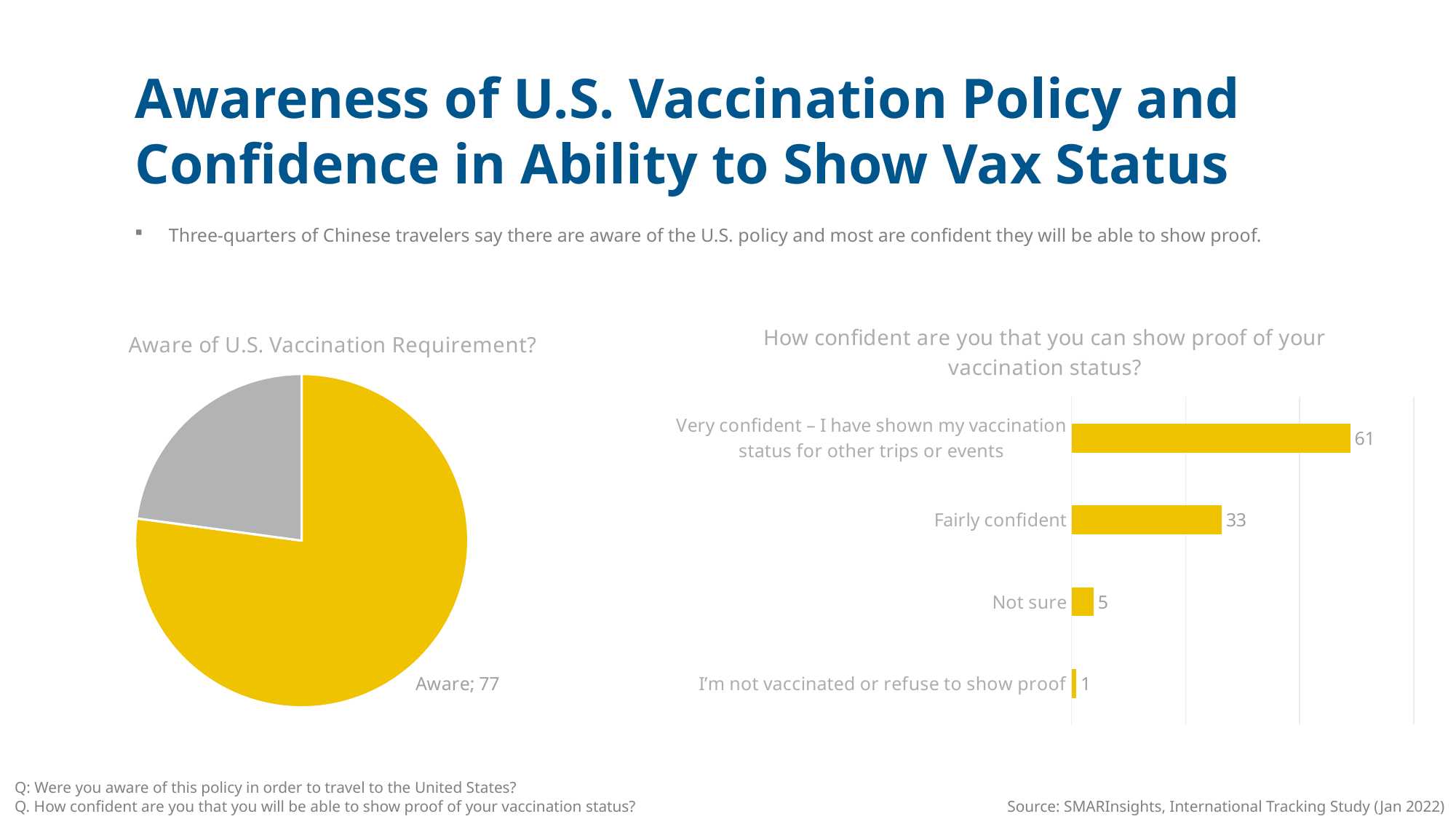
In the bar chart on the right, what is the value for "Not sure"? 5 In the bar chart on the right, what is the value for "Fairly confident"? 33 In the bar chart on the right, which category has the lowest value? I'm not vaccinated or refuse to show proof In the bar chart on the right, which is larger: the value for "Not sure" or the value for "Fairly confident"? Fairly confident In the bar chart on the right, what is the value for "Very confident – I have shown my vaccination status for other trips or events"? 61 How many categories are shown in the bar chart on the right? 4 In the bar chart on the right, which category has the highest value? Very confident – I have shown my vaccination status for other trips or events In the pie chart titled "Aware of U.S. Vaccination Requirement?", what value is shown for the Aware slice? 77 In the bar chart on the right, what is the difference between the values for "Very confident" and "Fairly confident"? 28 In the bar chart on the right, what is the value for "I'm not vaccinated or refuse to show proof"? 1 What kind of chart is the chart on the right of the slide? bar chart What kind of chart is the chart on the left of the slide? pie chart